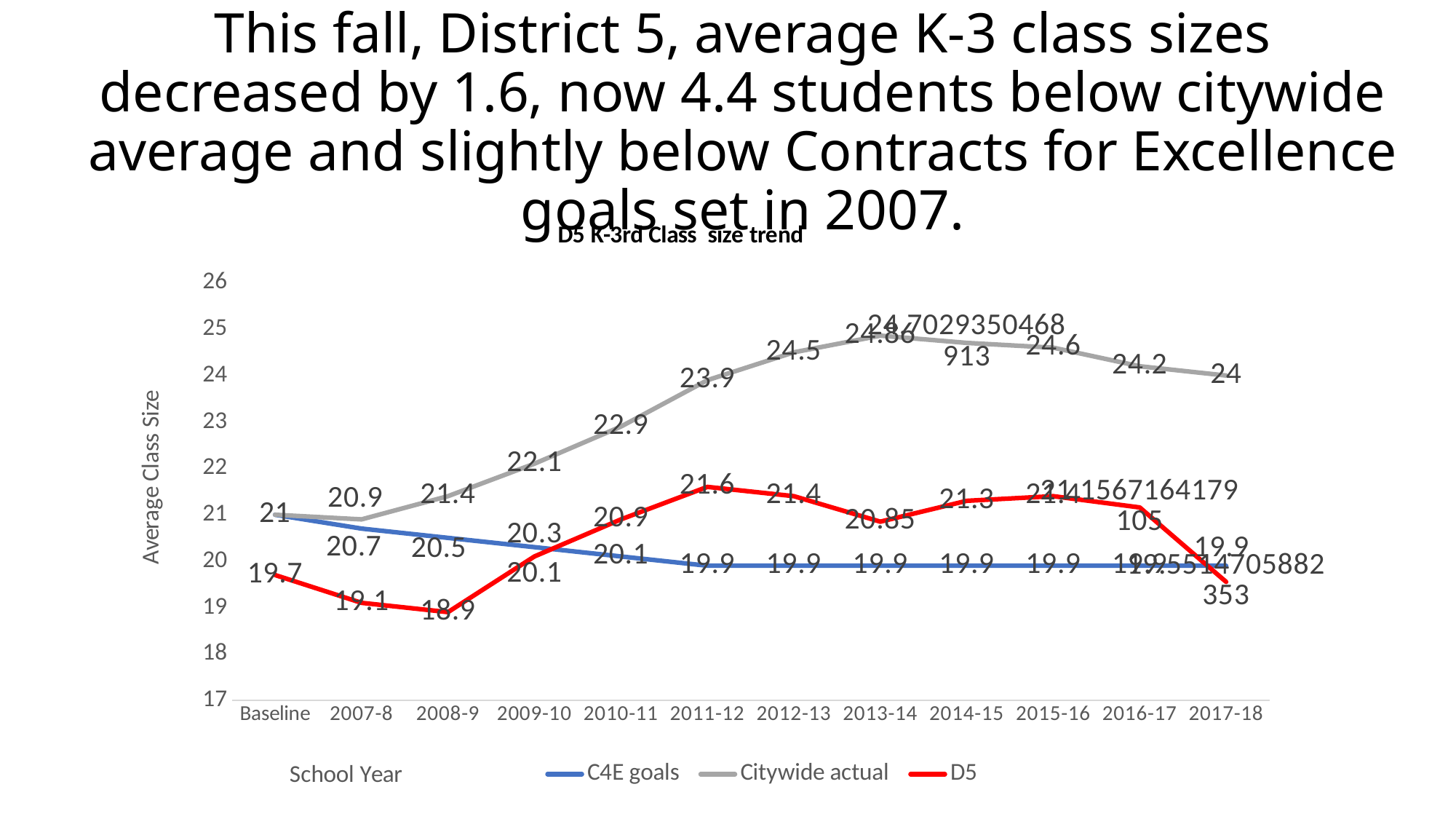
What is the title of the y axis? Average Class Size Does the Citywide actual series rise or fall from Baseline to 2012-13? rise What is the Citywide actual value for 2011-12? 23.9 What is the Citywide actual value for 2017-18? 24 How many school-year categories are shown on the x axis? 12 What is the difference between Citywide actual and D5 in 2011-12? 2.3 What is the D5 value for 2008-9? 18.9 How many series does the legend list? 3 What is the C4E goals value for 2009-10? 20.3 What kind of chart is shown on the slide? line chart Which is larger in 2011-12, Citywide actual or D5? Citywide actual In which school year is the D5 series at its lowest? 2008-9